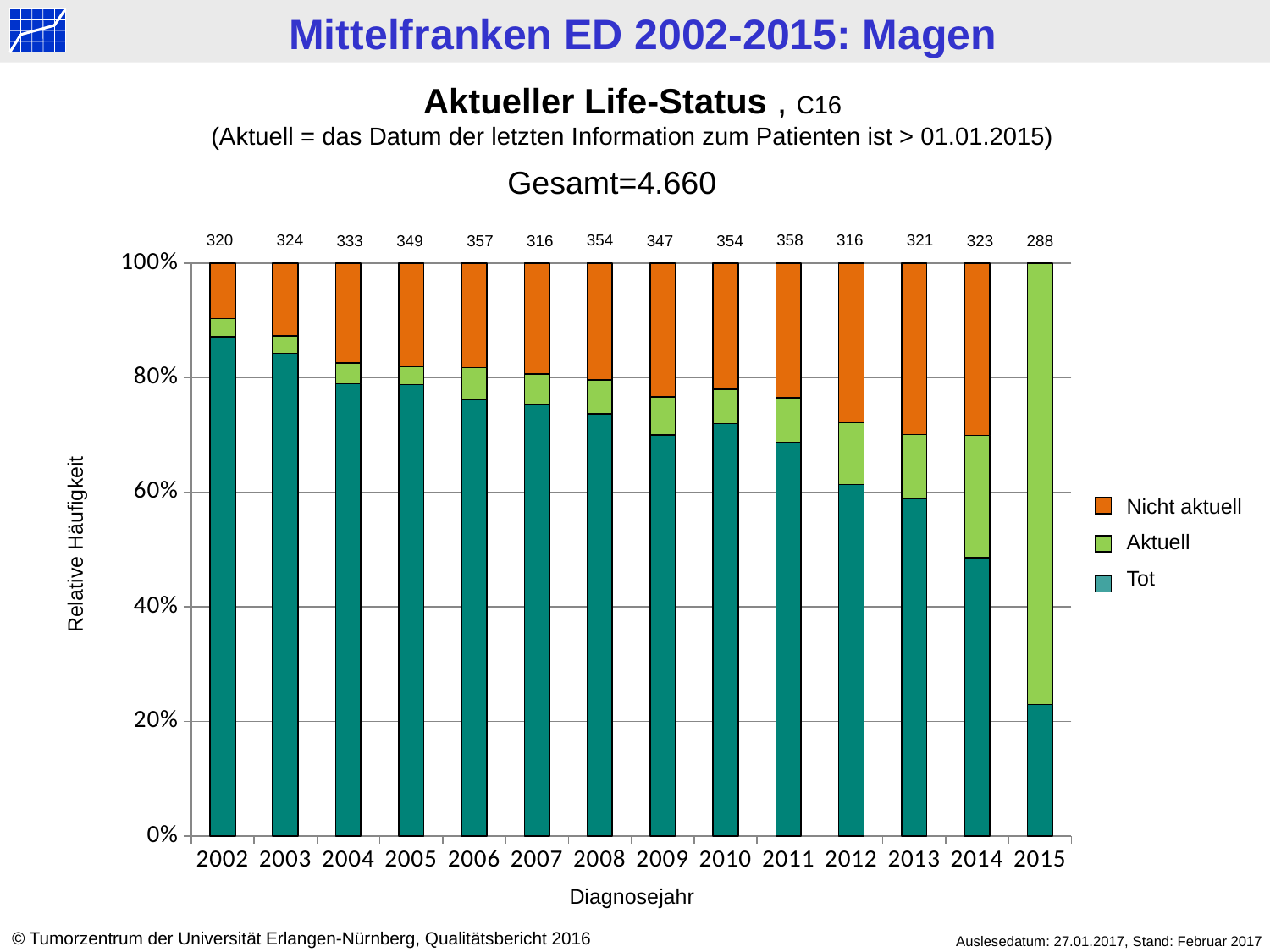
What is the difference between the numbers printed above the bars for 2011 and 2015? 70 Which diagnosis year has the lowest number printed above its bar? 2015 Does the 'Tot' share generally rise or fall from 2002 to 2015? fall Is the 'Tot' share for 2002 greater or less than 80%? greater How many diagnosis years are shown on the x axis? 14 Which year has the larger 'Tot' share, 2002 or 2015? 2002 How many series does the legend list? 3 What number is printed above the bar for 2011? 358 Is the 'Tot' share for 2015 greater or less than 40%? less What number is printed above the bar for 2006? 357 What number is printed above the bar for 2015? 288 Which diagnosis year has the highest number printed above its bar? 2011